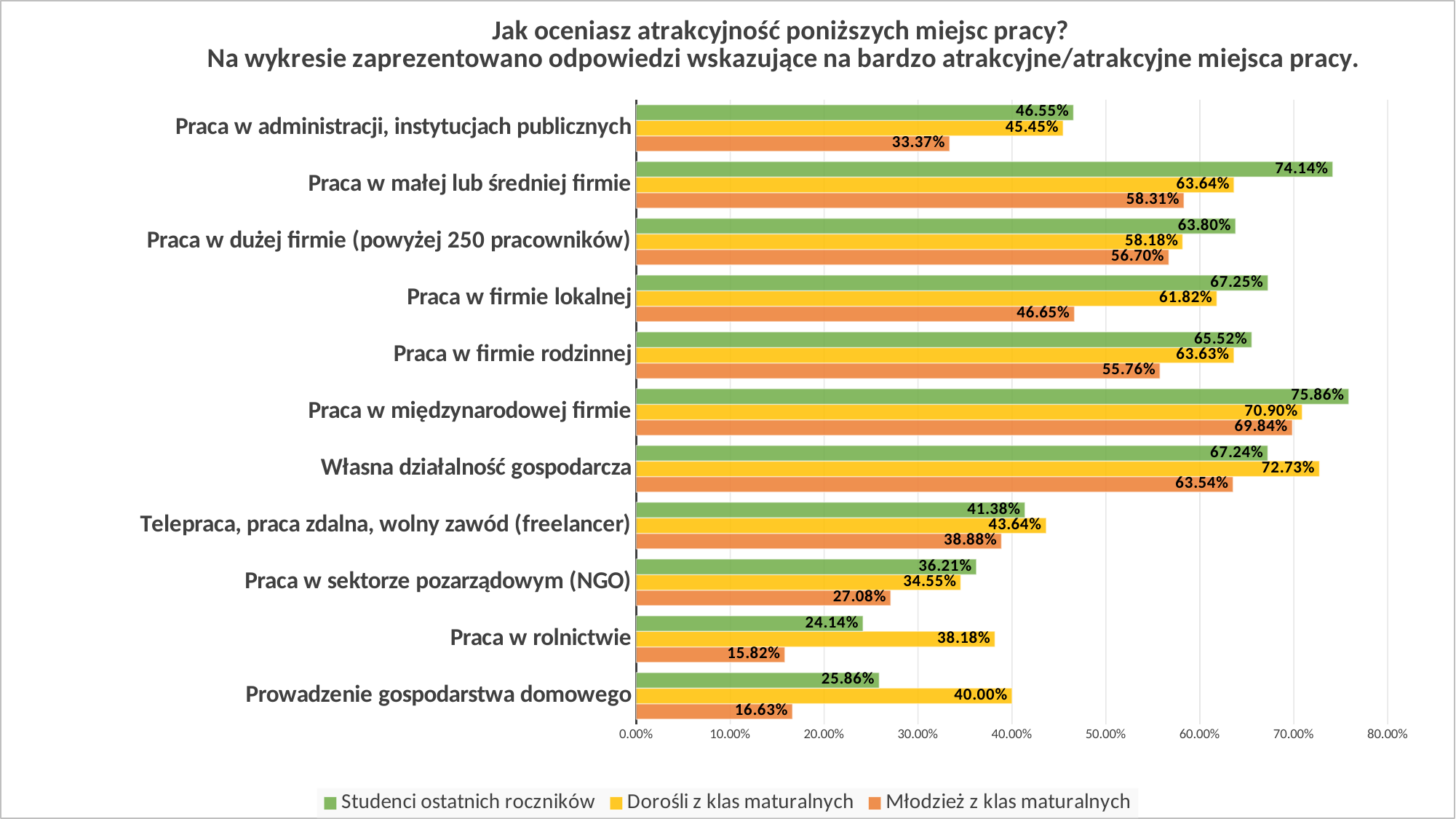
What is the value for Studenci ostatnich roczników for Praca w międzynarodowej firmie? 75.86% Which colour represents Dorośli z klas maturalnych in the legend? yellow Which category has the lowest value for Młodzież z klas maturalnych? Praca w rolnictwie What is the value for Dorośli z klas maturalnych for Prowadzenie gospodarstwa domowego? 40.00% What is the value for Młodzież z klas maturalnych for Praca w administracji, instytucjach publicznych? 33.37% How many categories (workplaces) are shown on the chart? 11 What kind of chart is shown on the slide? bar chart Is the value for Młodzież z klas maturalnych for Praca w firmie lokalnej greater or less than 50.00%? less How many series does the legend list? 3 For Własna działalność gospodarcza, which series has the larger value: Studenci ostatnich roczników or Dorośli z klas maturalnych? Dorośli z klas maturalnych Which category has the highest value for Studenci ostatnich roczników? Praca w międzynarodowej firmie What is the difference between the Studenci ostatnich roczników and Dorośli z klas maturalnych values for Praca w małej lub średniej firmie? 10.50 percentage points